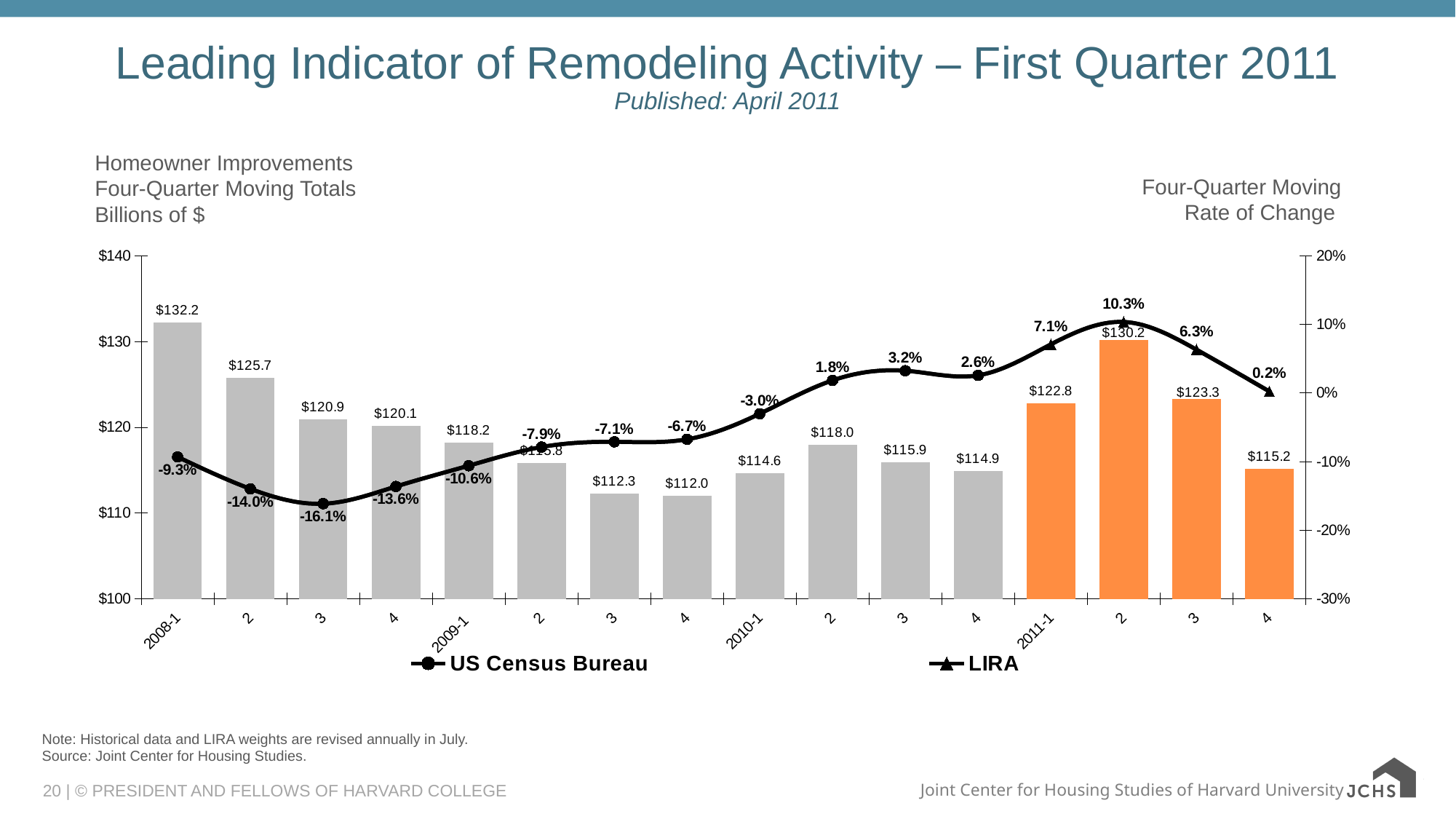
What is the four-quarter moving rate of change shown for 2011-2? 10.3% How many quarters (bars) are plotted on the chart? 16 How many series does the legend list? 2 What is the four-quarter moving total shown for 2011-4? $115.2 What are the two series named in the legend? US Census Bureau and LIRA What is the difference between the four-quarter moving totals for 2011-2 and 2011-1? $7.4 Which is larger, the four-quarter moving total for 2010-2 or for 2010-3? 2010-2 Does the four-quarter moving rate of change rise or fall from 2008-3 to 2011-2? rise What is the four-quarter moving total for homeowner improvements in 2008-1? $132.2 Which quarter has the lowest four-quarter moving total bar? 2009-4 Which quarter has the lowest four-quarter moving rate of change? 2008-3 Which quarter has the highest four-quarter moving total bar? 2008-1